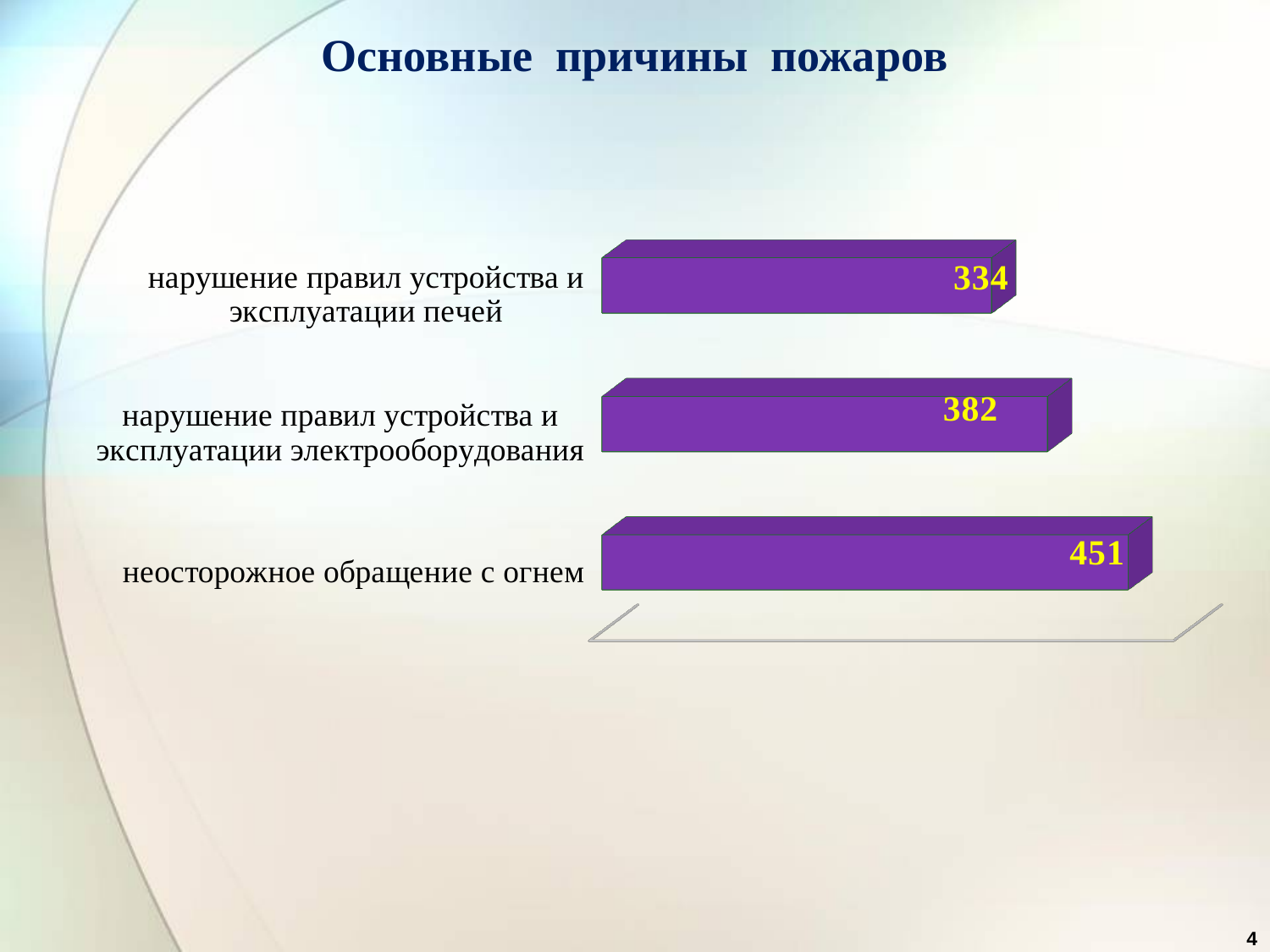
What colour are the bars in the chart? purple Which category has the highest value? неосторожное обращение с огнем How many categories are shown in the chart? 3 Which category has the lowest value? нарушение правил устройства и эксплуатации печей What kind of chart is shown on the slide? bar chart Which is larger: the value for "нарушение правил устройства и эксплуатации электрооборудования" or for "нарушение правил устройства и эксплуатации печей"? нарушение правил устройства и эксплуатации электрооборудования What is the value for "неосторожное обращение с огнем"? 451 What is the value for "нарушение правил устройства и эксплуатации печей"? 334 What is the title of the slide? Основные причины пожаров What is the difference between the values for "нарушение правил устройства и эксплуатации электрооборудования" and "нарушение правил устройства и эксплуатации печей"? 48 What is the value for "нарушение правил устройства и эксплуатации электрооборудования"? 382 What is the difference between the values for "неосторожное обращение с огнем" and "нарушение правил устройства и эксплуатации печей"? 117